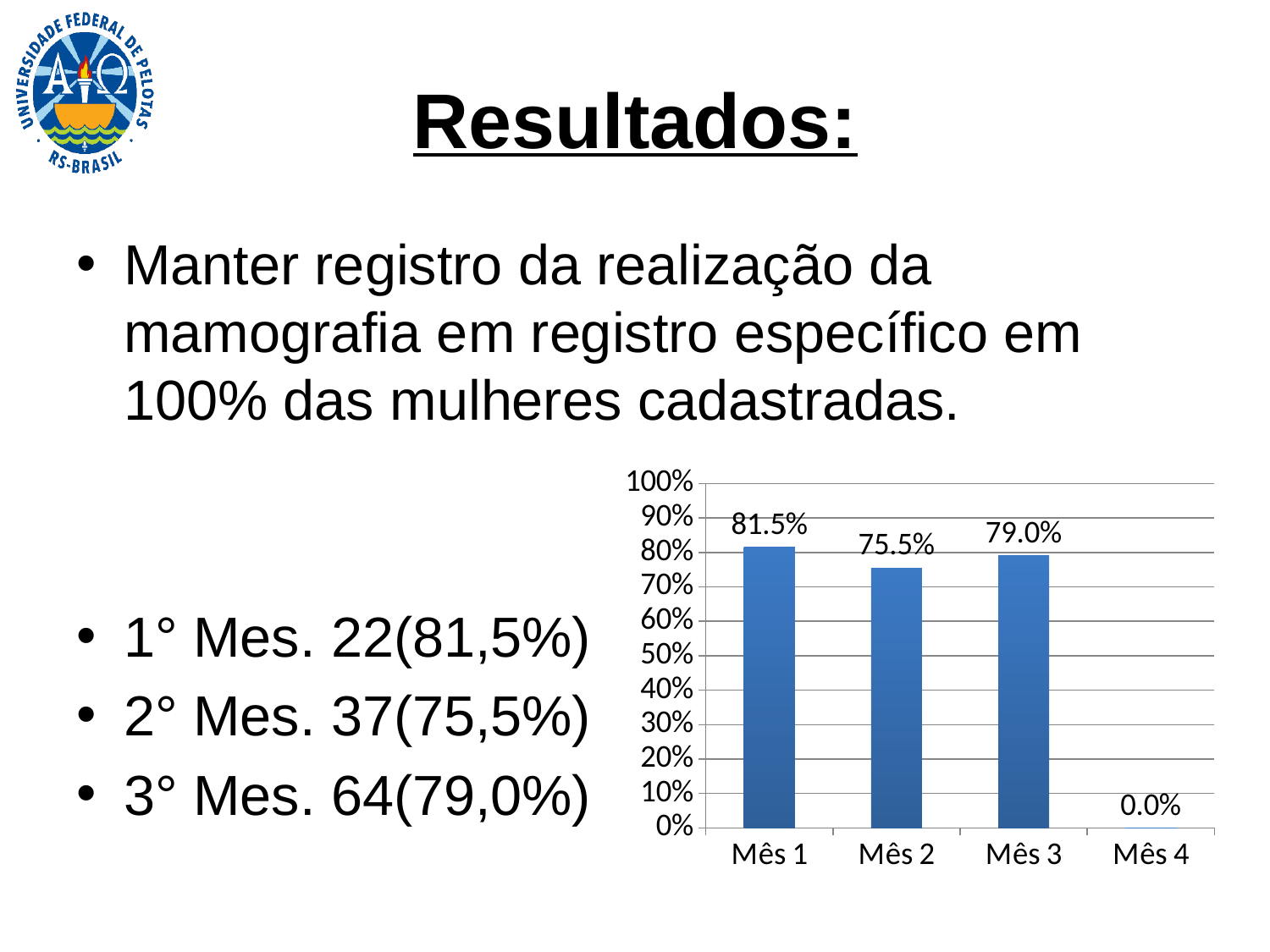
What is the value for Mês 4? 0.0% Which month has the lowest value? Mês 4 What is the value for Mês 1? 81.5% What is the maximum value shown on the y axis? 100% Which month has the highest value? Mês 1 How many categories are shown on the x axis? 4 What kind of chart is shown on the slide? bar chart What is the difference between the values for Mês 1 and Mês 2? 6.0% Which is larger, the value for Mês 2 or Mês 3? Mês 3 Is the value for Mês 1 greater or less than 80%? greater What is the value for Mês 2? 75.5% What is the value for Mês 3? 79.0%